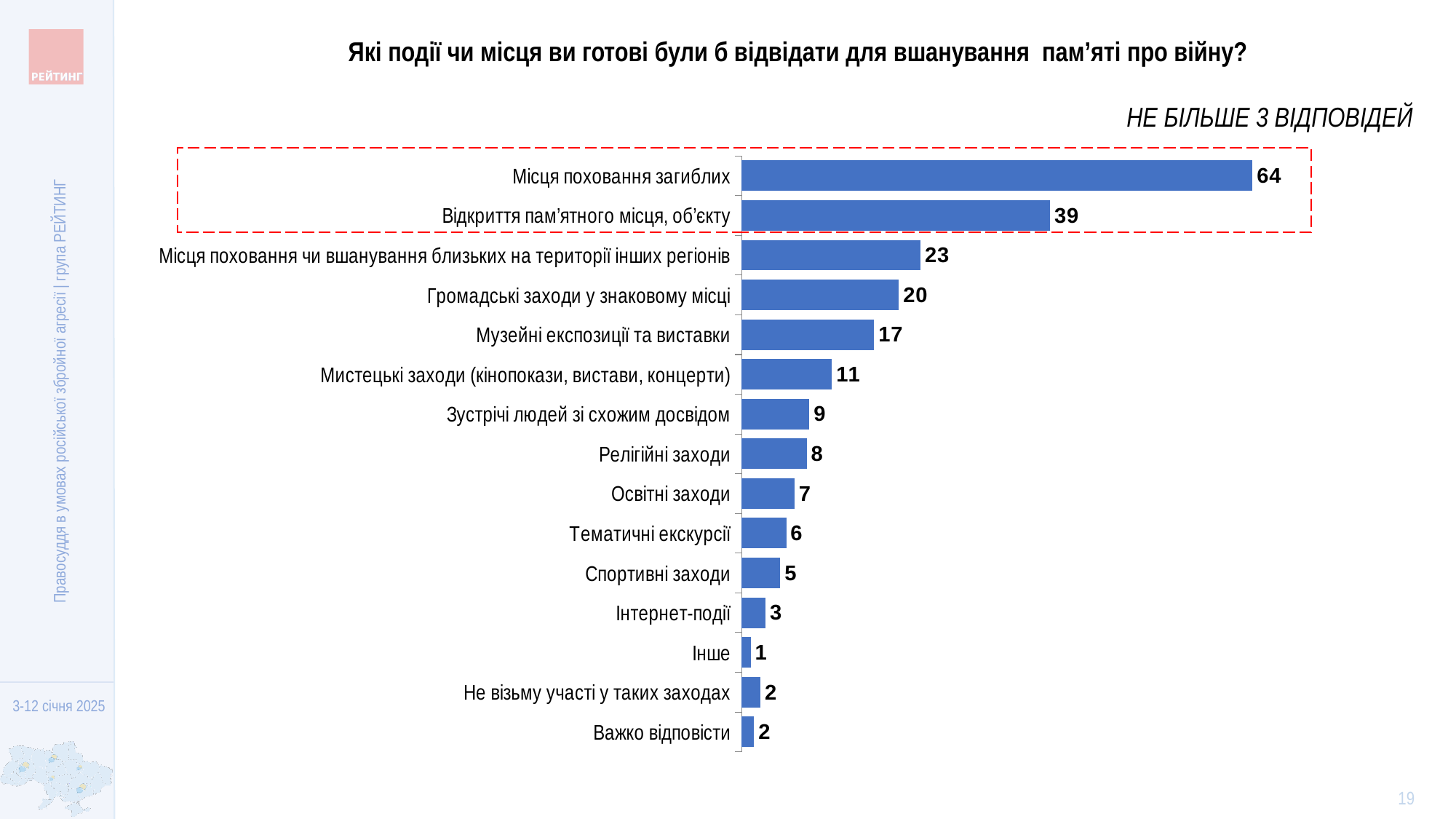
What is the value for "Місця поховання загиблих"? 64 What is the title of the chart? Які події чи місця ви готові були б відвідати для вшанування пам’яті про війну? What is the difference between the values for "Громадські заходи у знаковому місці" and "Мистецькі заходи (кінопокази, вистави, концерти)"? 9 What is the value for "Музейні експозиції та виставки"? 17 Which category has the highest value? Місця поховання загиблих Which is larger: the value for "Релігійні заходи" or the value for "Освітні заходи"? Релігійні заходи How many categories are shown in the chart? 15 What is the difference between the values for "Місця поховання загиблих" and "Відкриття пам’ятного місця, об’єкту"? 25 Which category has the lowest value? Інше What is the value for "Інтернет-події"? 3 What is the value for "Тематичні екскурсії"? 6 What kind of chart is shown on the slide? Bar chart